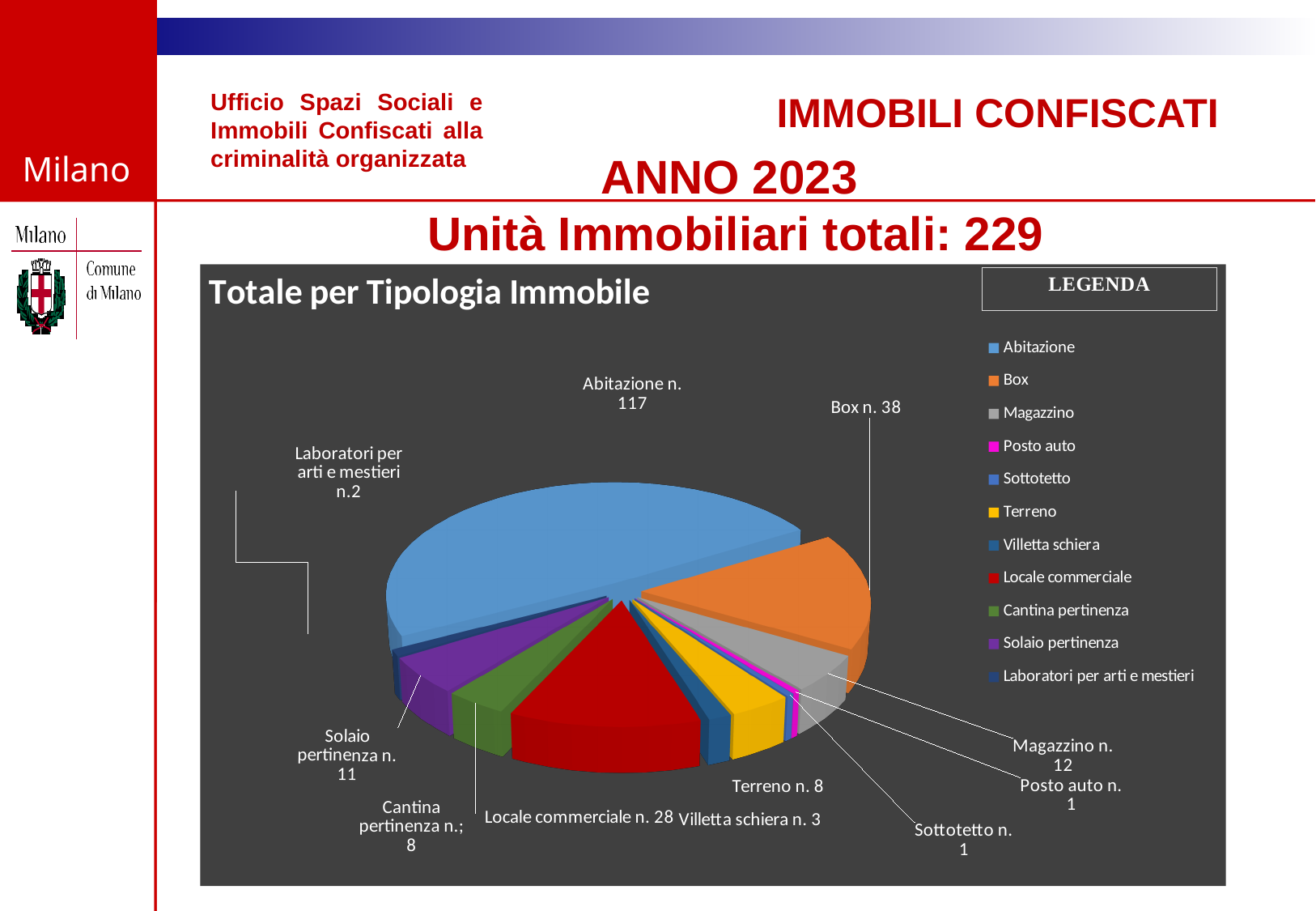
What type of chart is shown on the slide? Pie chart How many entries does the legend list? 11 What is the value for Abitazione? 117 What is the value for Locale commerciale? 28 Which category has the largest slice? Abitazione What share of the total of 229 does Abitazione represent? 51.1% How many categories are shown in the pie chart? 11 What is the title of the chart? Totale per Tipologia Immobile What is the value for Solaio pertinenza? 11 Which is larger, Magazzino or Terreno? Magazzino What is the value for Box? 38 What is the difference between the values for Abitazione and Box? 79